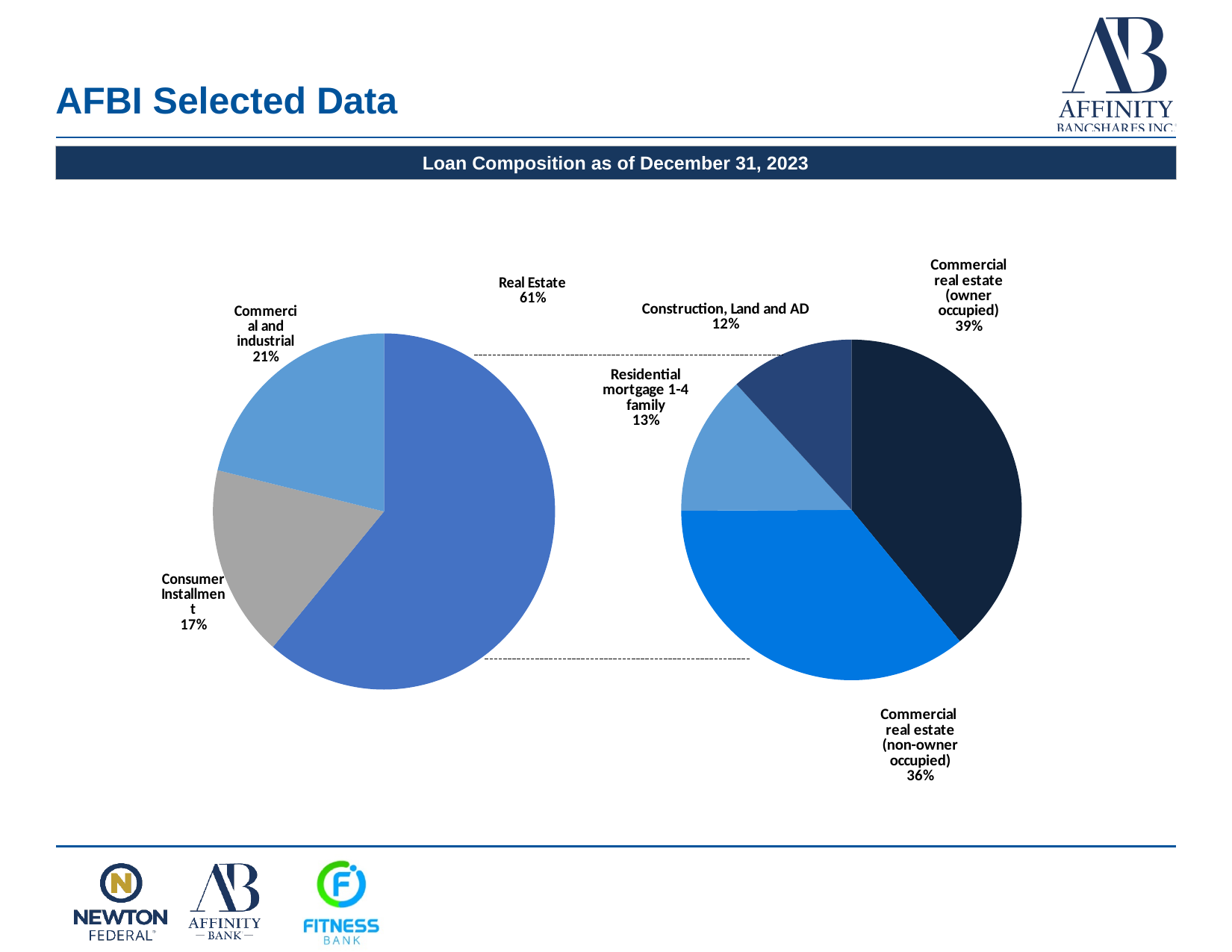
In the left pie chart, which is larger: Commercial and industrial or Consumer Installment? Commercial and industrial In the right pie chart, what share is Construction, Land and AD? 12% What type of chart is used on this slide to show loan composition? Pie chart In the left pie chart, what share of loans is Real Estate? 61% How many slices does the right pie chart have? 4 In the left pie chart, which category has the largest share? Real Estate In the left pie chart, what percentage is Commercial and industrial? 21% In the right pie chart, what is the difference in percentage points between Commercial real estate (owner occupied) and Commercial real estate (non-owner occupied)? 3 percentage points In the left pie chart, what percentage is Consumer Installment? 17% In the right pie chart, which category has the smallest share? Construction, Land and AD In the right pie chart, what share is Commercial real estate (owner occupied)? 39% In the right pie chart, what share is Residential mortgage 1-4 family? 13%